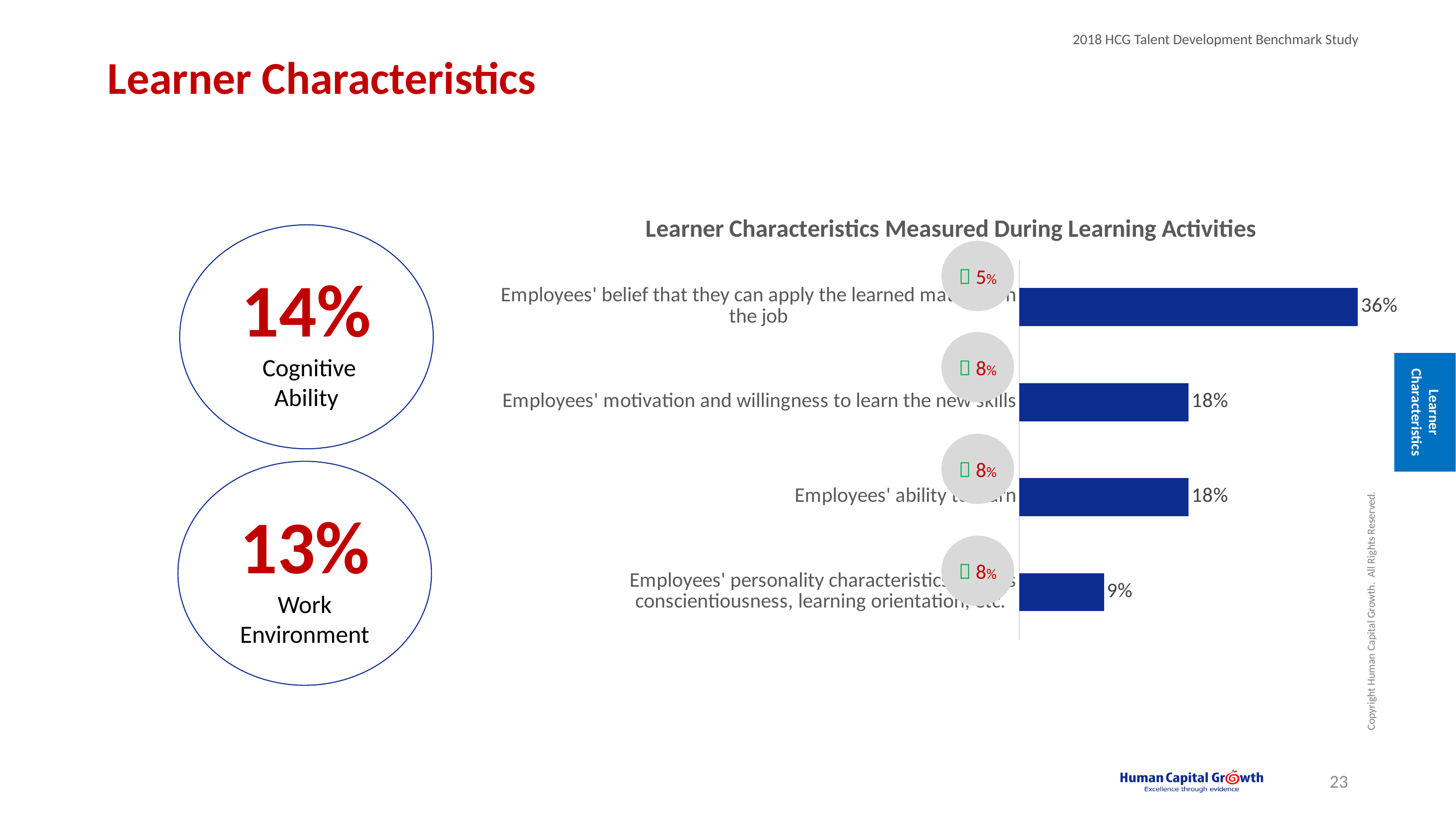
What is the value for the bar about employees' belief that they can apply the learned material on the job? 36% What type of chart is shown on the slide? bar chart Which category has the lowest value? Employees' personality characteristics such as conscientiousness, learning orientation, etc. What is the difference between the value for employees' belief that they can apply the learned material on the job and the value for employees' ability to learn? 18 percentage points Which is larger: the value for employees' motivation and willingness to learn the new skills or the value for employees' personality characteristics? Employees' motivation and willingness to learn the new skills What is the value for the bar about employees' personality characteristics (conscientiousness, learning orientation, etc.)? 9% What is the value for "Employees' motivation and willingness to learn the new skills"? 18% What is the title of the chart? Learner Characteristics Measured During Learning Activities How many categories (bars) does the chart show? 4 What is the value for "Employees' ability to learn"? 18% What colour are the bars in the chart? dark blue Which category has the highest value? Employees' belief that they can apply the learned material on the job